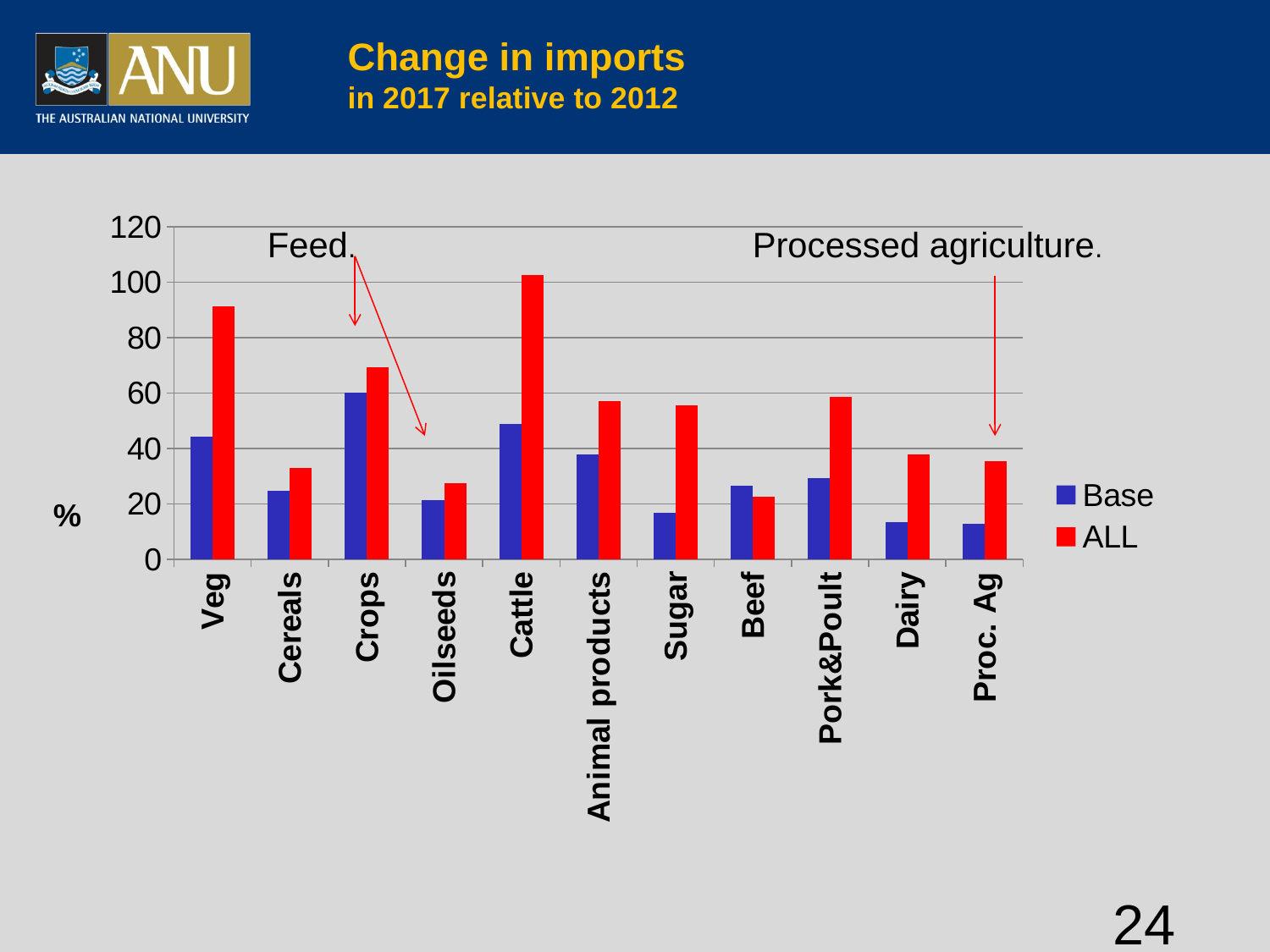
Is the ALL value for Cattle greater or less than 100? greater Is the Base value for Crops greater or less than 40? greater How many series does the legend list? 2 How many categories are shown on the x axis? 11 Which category has the highest ALL value? Cattle Which category has the highest Base value? Crops What are the two series names shown in the legend? Base and ALL Which is larger, the ALL value for Veg or the ALL value for Crops? Veg Is the ALL value for Veg greater or less than 80? greater For Beef, which is larger, the Base value or the ALL value? Base What kind of chart is shown on the slide? bar chart